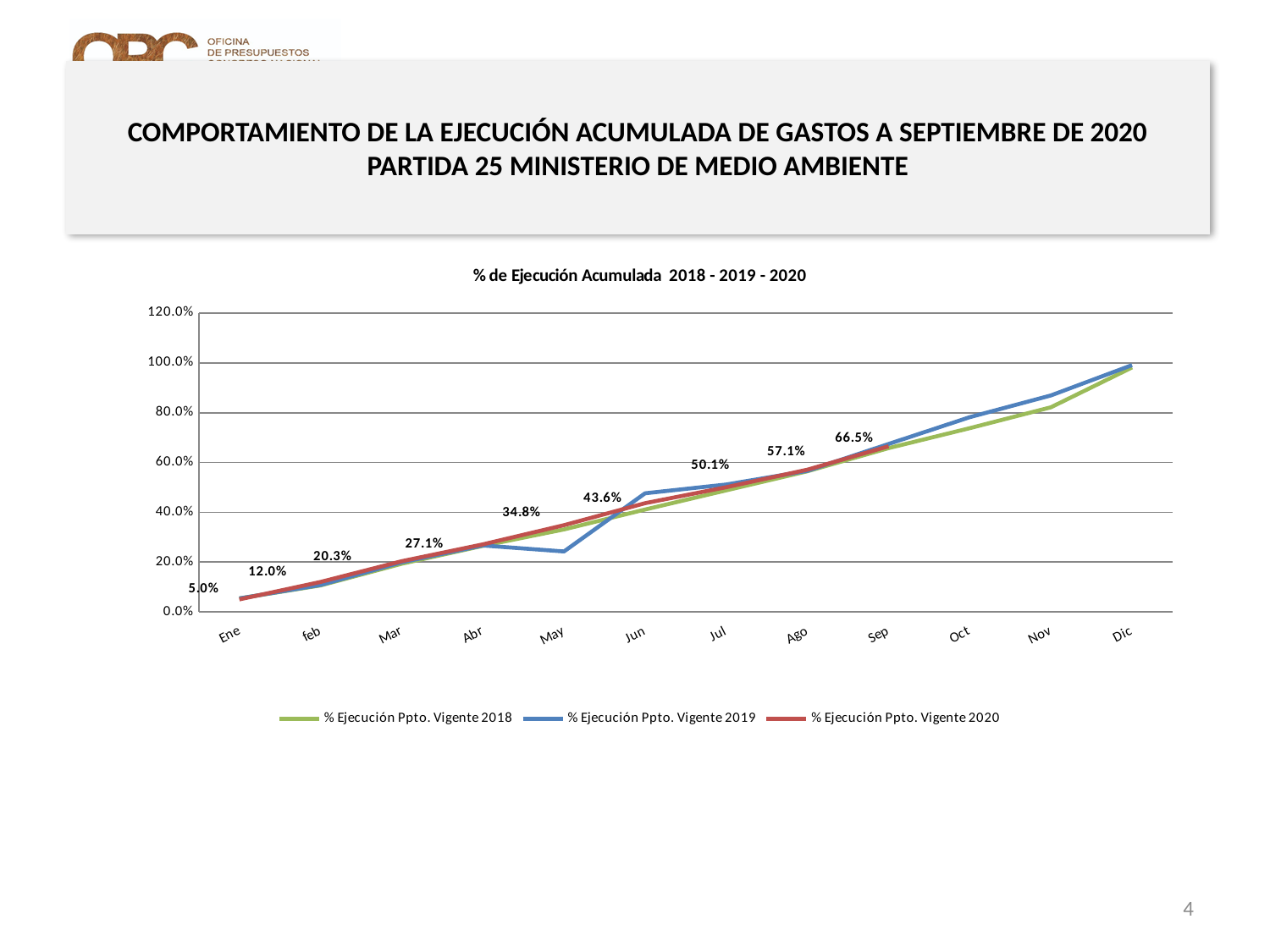
What kind of chart is shown on the slide? Line chart How many months are shown on the x axis? 12 Is the value for % Ejecución Ppto. Vigente 2019 in May greater or less than 40.0%? less In May, which series has the larger value: 2019 or 2020? 2020 What is the value of % Ejecución Ppto. Vigente 2020 in Sep? 66.5% By how many percentage points does the 2020 series increase from Ago to Sep? 9.4 percentage points What is the title of the chart? % de Ejecución Acumulada 2018 - 2019 - 2020 Does the 2020 series rise or fall from Ene to Sep? Rise How many series does the legend list? 3 What is the value of % Ejecución Ppto. Vigente 2020 in Ene? 5.0% By how many percentage points does the 2020 series increase from Ene to feb? 7.0 percentage points What is the value of % Ejecución Ppto. Vigente 2020 in Jun? 43.6%